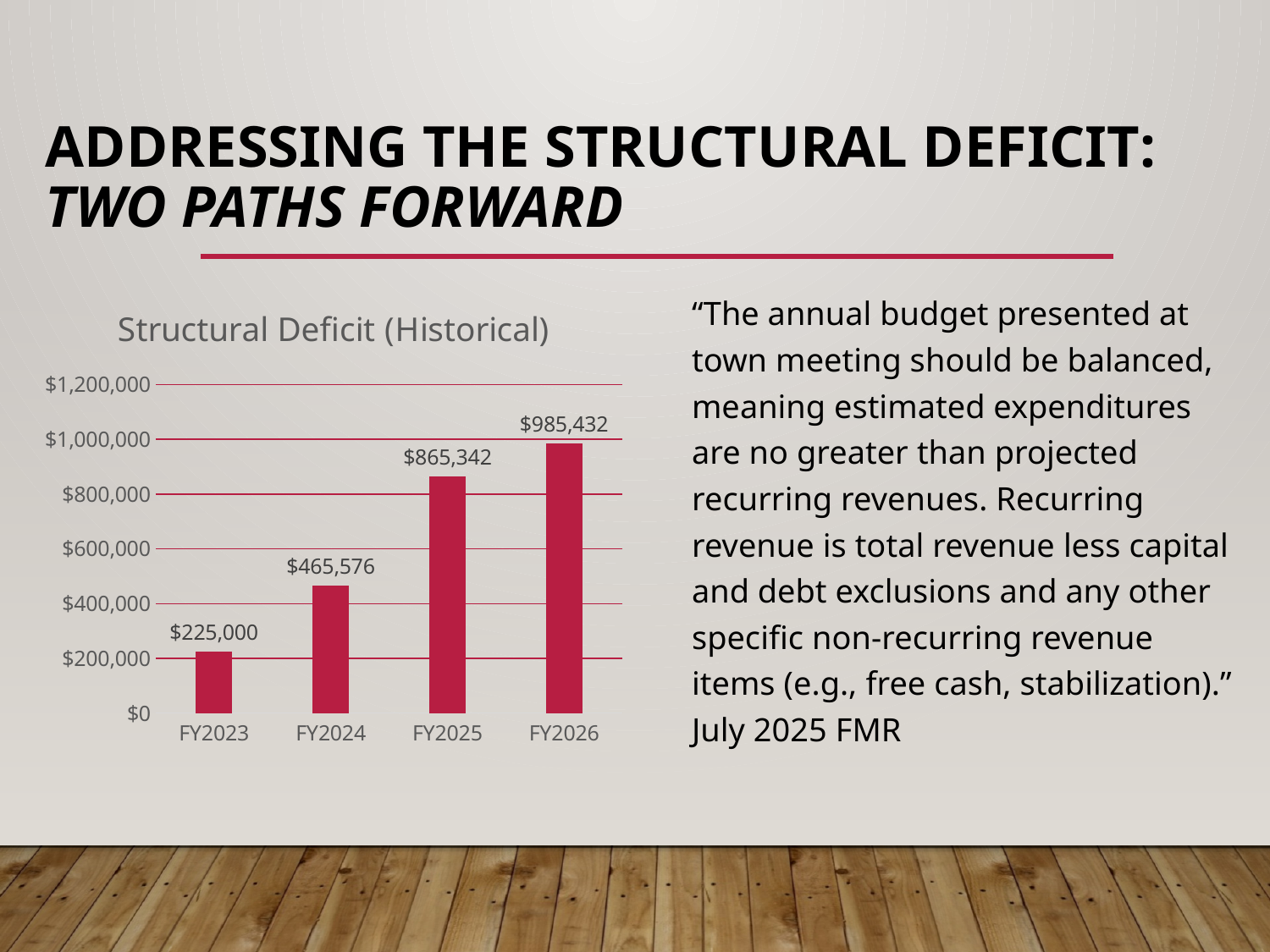
Which is larger, the structural deficit for FY2024 or FY2025? FY2025 Which fiscal year has the lowest structural deficit? FY2023 Does the structural deficit rise or fall from FY2023 to FY2026? Rise What is the structural deficit for FY2025? $865,342 Which fiscal year has the highest structural deficit? FY2026 What is the difference between the FY2024 and FY2023 structural deficits? $240,576 What is the structural deficit for FY2024? $465,576 What kind of chart is used to show the structural deficit? Bar chart How many fiscal years are shown in the chart? 4 What is the structural deficit for FY2023? $225,000 What is the difference between the FY2026 and FY2025 structural deficits? $120,090 What is the structural deficit for FY2026? $985,432